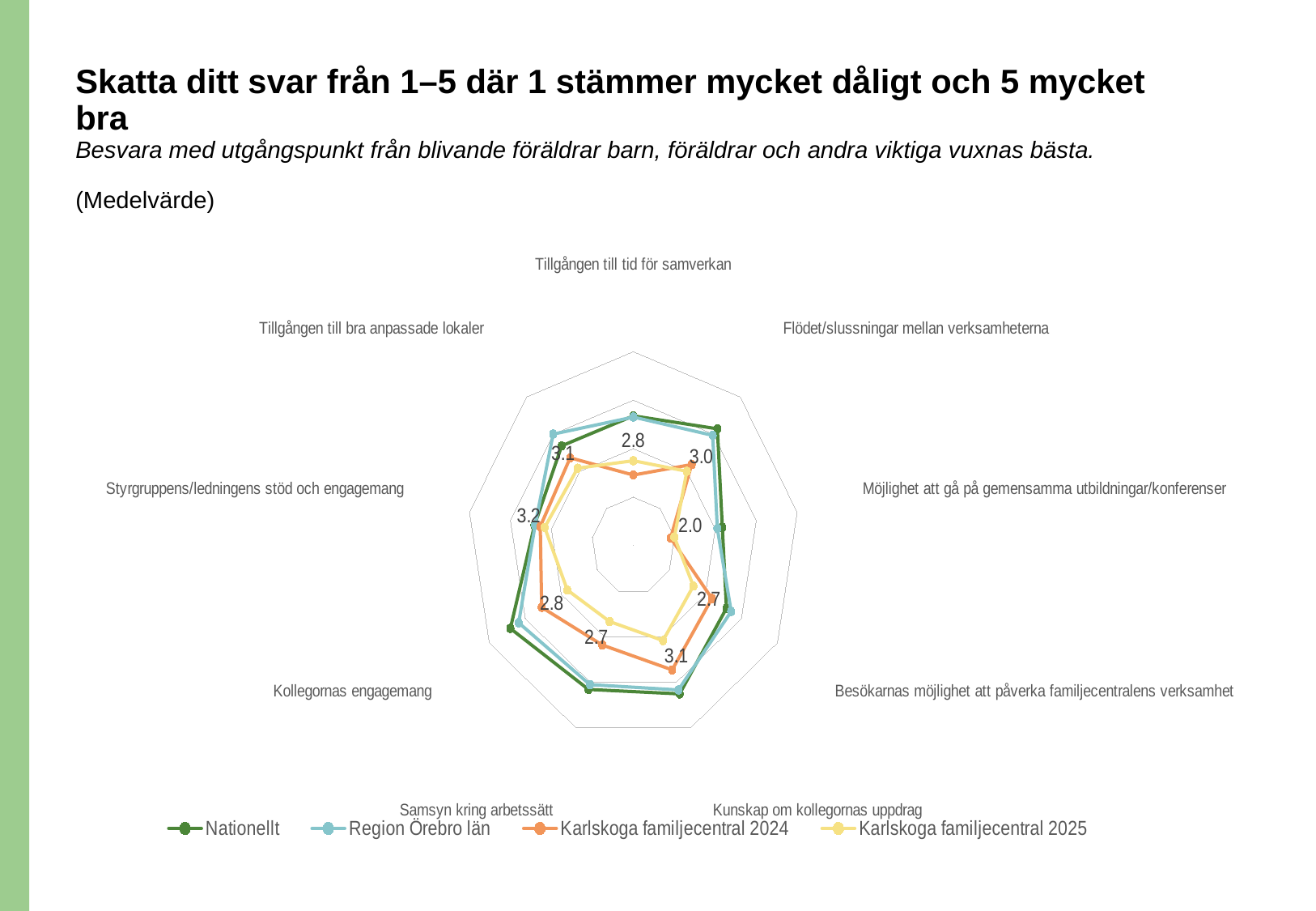
Which category has the lowest value for Karlskoga familjecentral 2024? Möjlighet att gå på gemensamma utbildningar/konferenser How many categories (axes) does the radar chart have? 9 How many series does the legend list? 4 What kind of chart is shown on the slide? Radar chart Which series is drawn in dark green in the legend? Nationellt Which category has the highest value for Karlskoga familjecentral 2024? Kunskap om kollegornas uppdrag